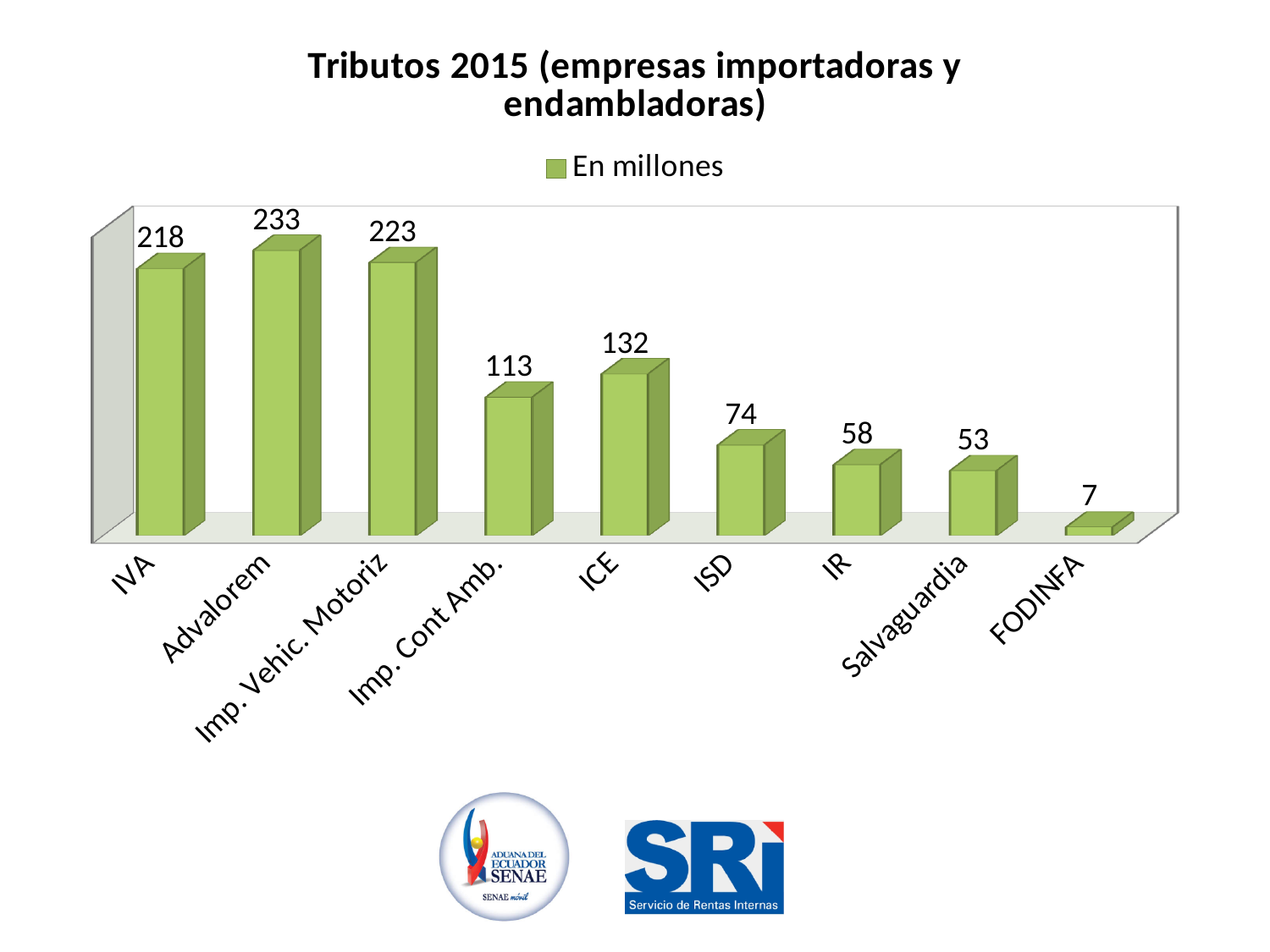
What is the value for Imp. Cont Amb.? 113 Which category has the lowest value? FODINFA Which is larger, the value for IR or the value for Salvaguardia? IR What is the value for IVA? 218 What kind of chart is shown on the slide? bar chart How many series does the legend list? 1 Which category has the highest value? Advalorem What is the difference between the values for ICE and ISD? 58 How many categories are shown on the x axis? 9 What is the value for Salvaguardia? 53 What is the difference between the values for Advalorem and Imp. Vehic. Motoriz? 10 What is the legend entry for the series? En millones